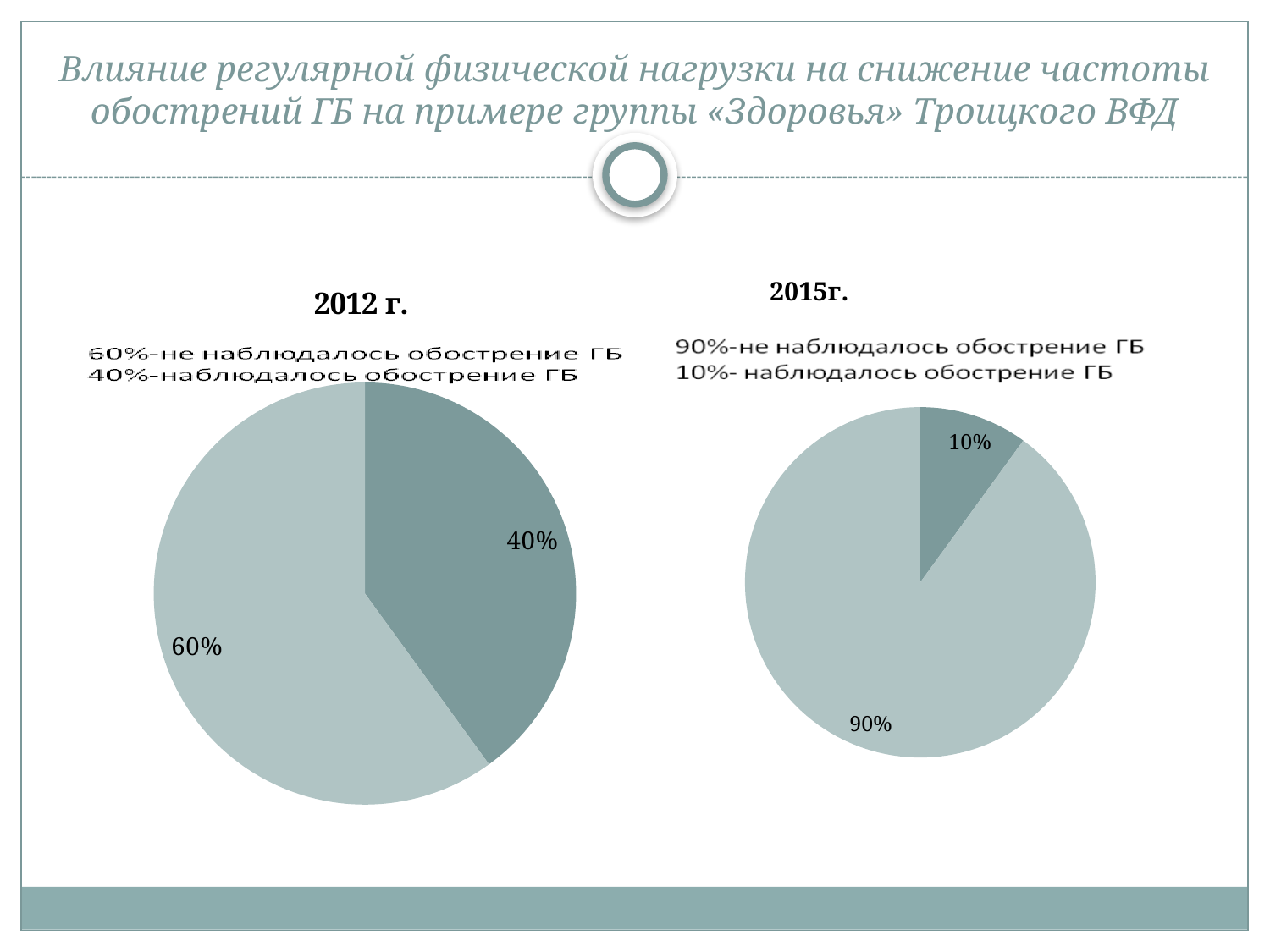
In the "2015г." chart, what is the difference between the two slices? 80% In the "2012 г." chart, what is the difference between the two slices? 20% In the "2012 г." chart, what share of the pie corresponds to "наблюдалось обострение ГБ"? 40% How many slices does the "2015г." pie chart have? 2 What kind of chart is the "2012 г." chart on the left? Pie chart In the "2015г." chart, which category has the smallest slice? наблюдалось обострение ГБ In the "2012 г." chart, what share of the pie corresponds to "не наблюдалось обострение ГБ"? 60% In the "2012 г." chart, which category has the largest slice? не наблюдалось обострение ГБ In the "2015г." chart, what share of the pie corresponds to "не наблюдалось обострение ГБ"? 90% Which is larger: the "наблюдалось обострение ГБ" slice in the "2012 г." chart or in the "2015г." chart? 2012 г. What kind of chart is the "2015г." chart on the right? Pie chart